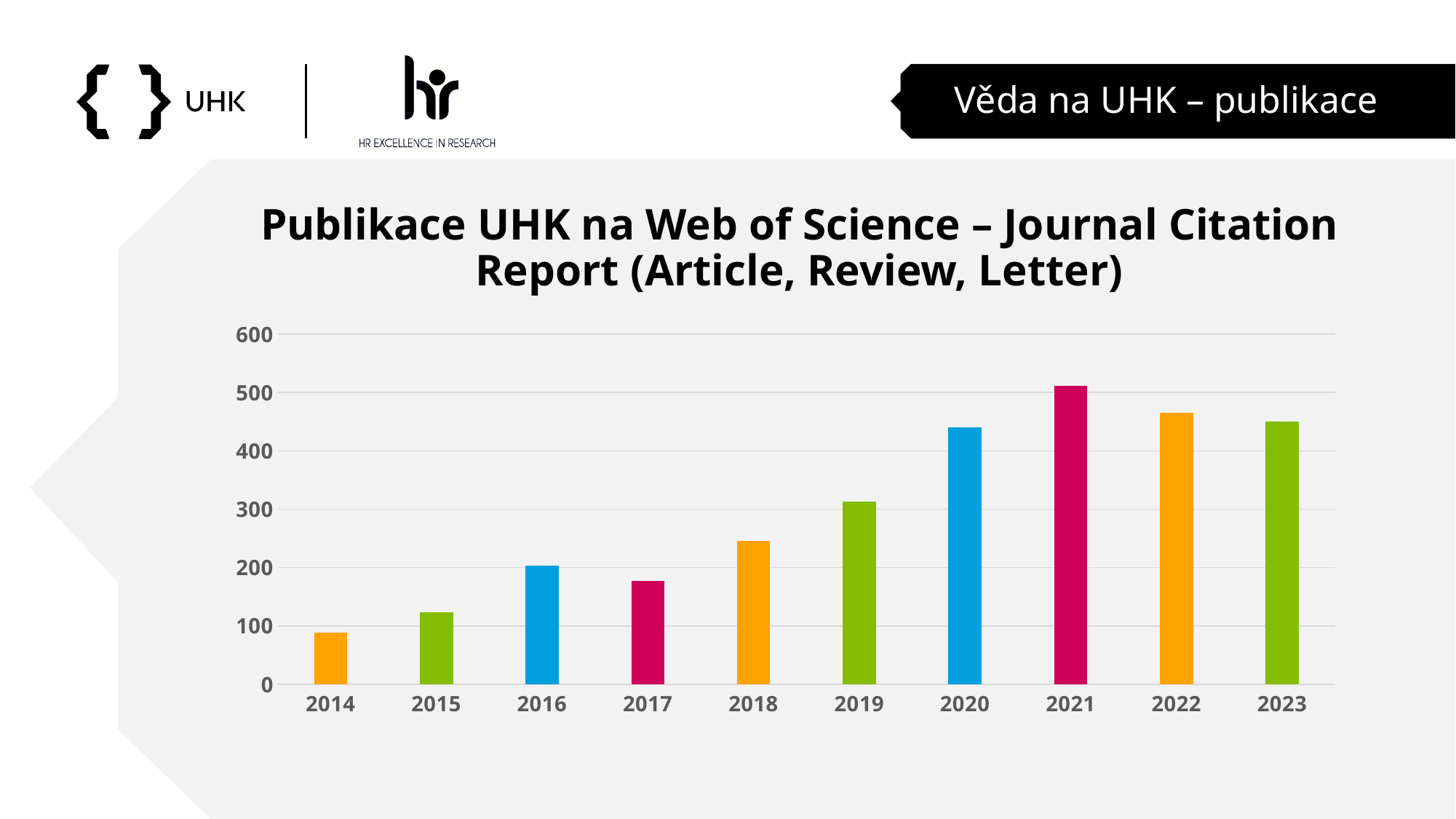
Is the value for 2021 greater or less than 500? greater Is the value for 2014 greater or less than 100? less Which year has the larger value, 2016 or 2017? 2016 Do the values generally rise or fall from 2014 to 2021? rise Is the value for 2018 greater or less than 300? less How many years are shown on the x axis of the chart? 10 What is the title of the chart? Publikace UHK na Web of Science – Journal Citation Report (Article, Review, Letter) Which year has the highest number of publications? 2021 What kind of chart is shown on the slide? bar chart Which year has the lowest number of publications? 2014